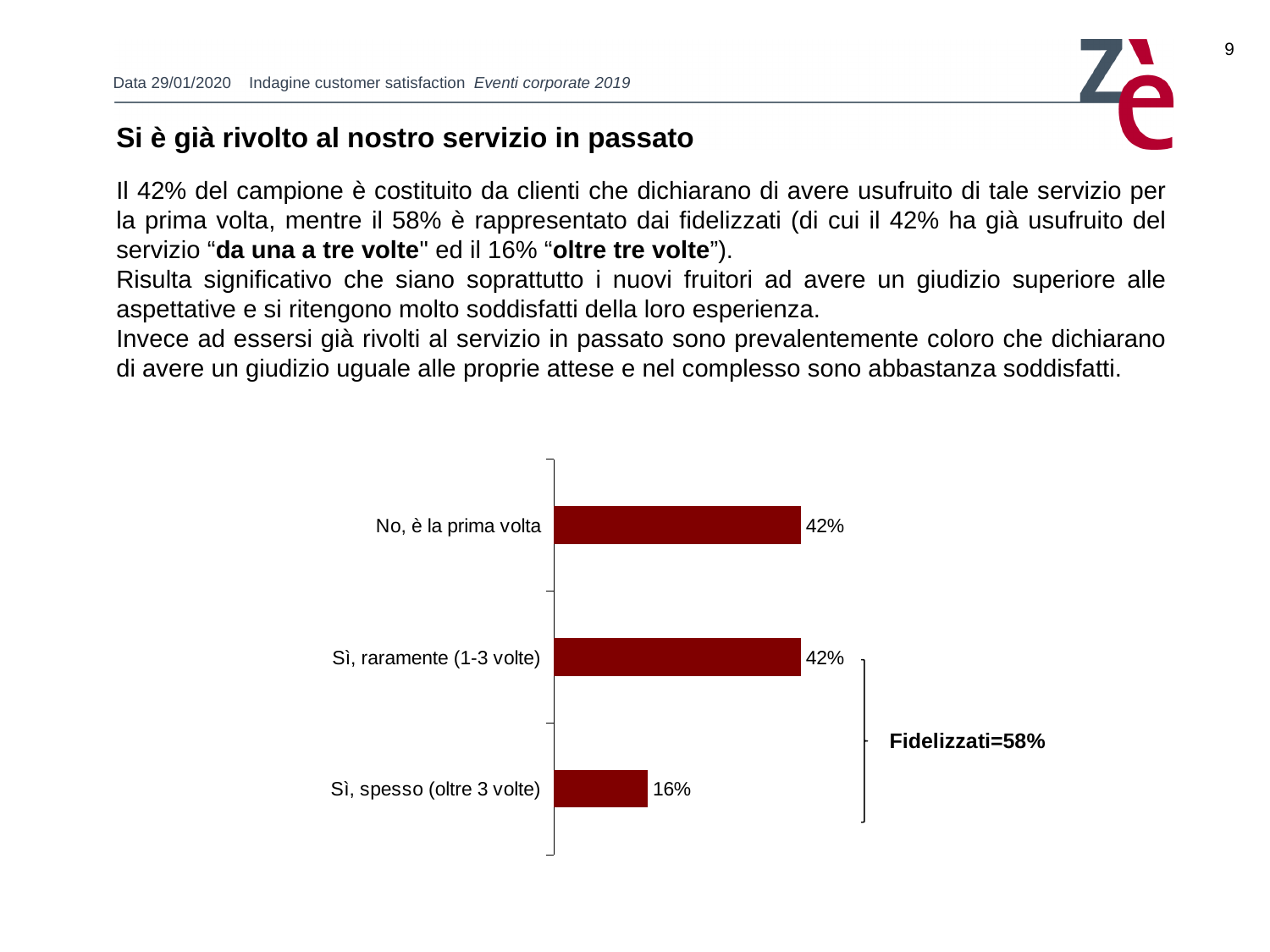
Which category has the lowest value? Sì, spesso (oltre 3 volte) What is the value for "Sì, spesso (oltre 3 volte)"? 16% Which is larger, the value for "No, è la prima volta" or the value for "Sì, spesso (oltre 3 volte)"? No, è la prima volta What is the difference between the values for "Sì, raramente (1-3 volte)" and "Sì, spesso (oltre 3 volte)"? 26% What label is shown next to the bracket grouping the two "Sì" categories? Fidelizzati=58% How many categories are shown in the chart? 3 What colour are the bars in the chart? Dark red What is the combined value of "Sì, raramente (1-3 volte)" and "Sì, spesso (oltre 3 volte)"? 58% What is the value for "Sì, raramente (1-3 volte)"? 42% What kind of chart is shown on the slide? Bar chart What is the value for "No, è la prima volta"? 42%